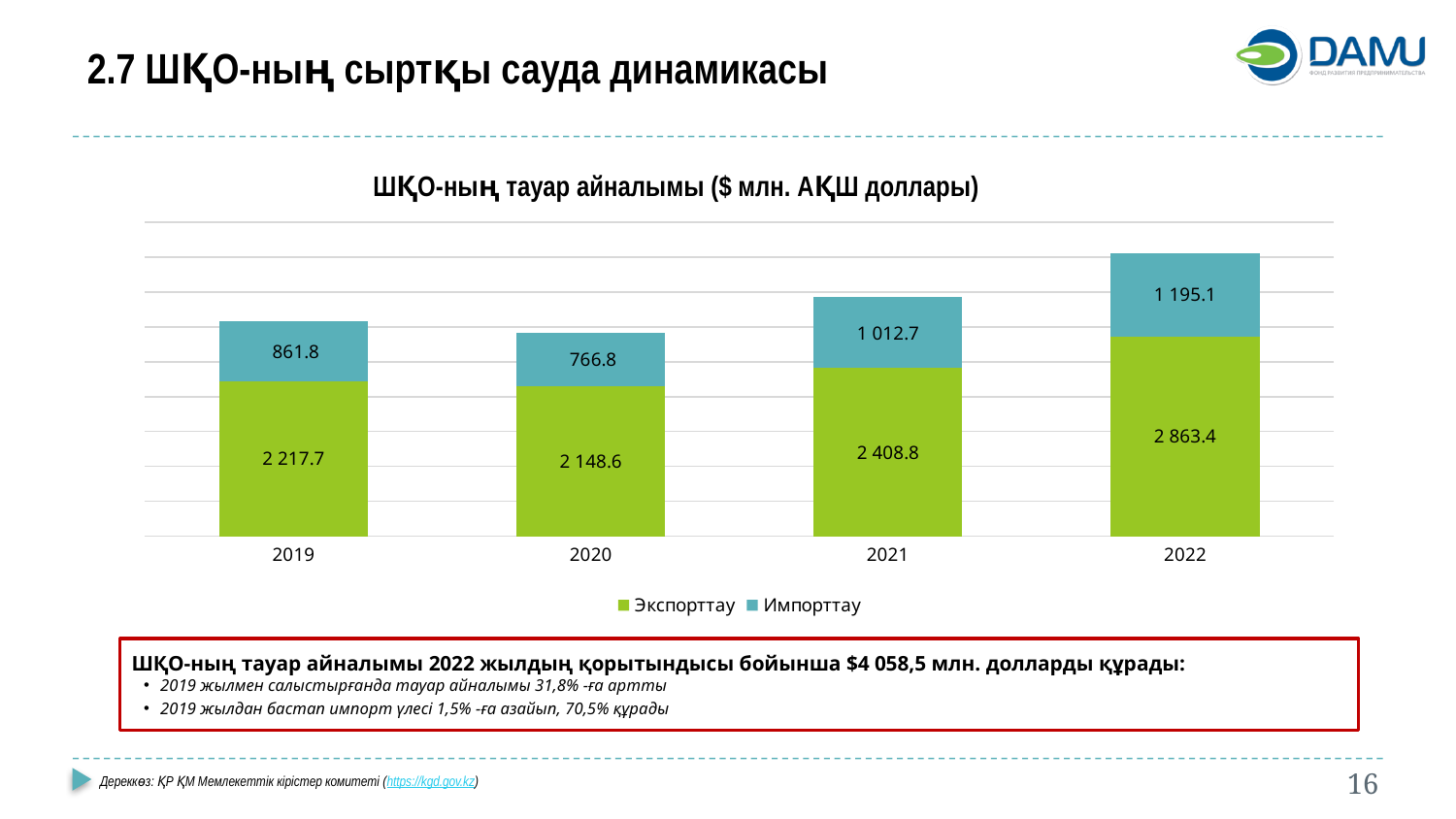
What is the Экспорттау value for 2022? 2 863.4 What is the Импорттау value for 2021? 1 012.7 What is the difference between the Экспорттау values for 2022 and 2021? 454.6 How many years are shown on the x axis? 4 What kind of chart is shown on the slide? Stacked bar chart What is the total of the stacked bar for 2019? 3 079.5 What is the total of the stacked bar for 2022? 4 058.5 How many series does the legend list? 2 Which year has the highest Экспорттау value? 2022 What is the Импорттау value for 2020? 766.8 Which year has the lowest Импорттау value? 2020 Which is larger, the Импорттау value for 2019 or for 2020? 2019